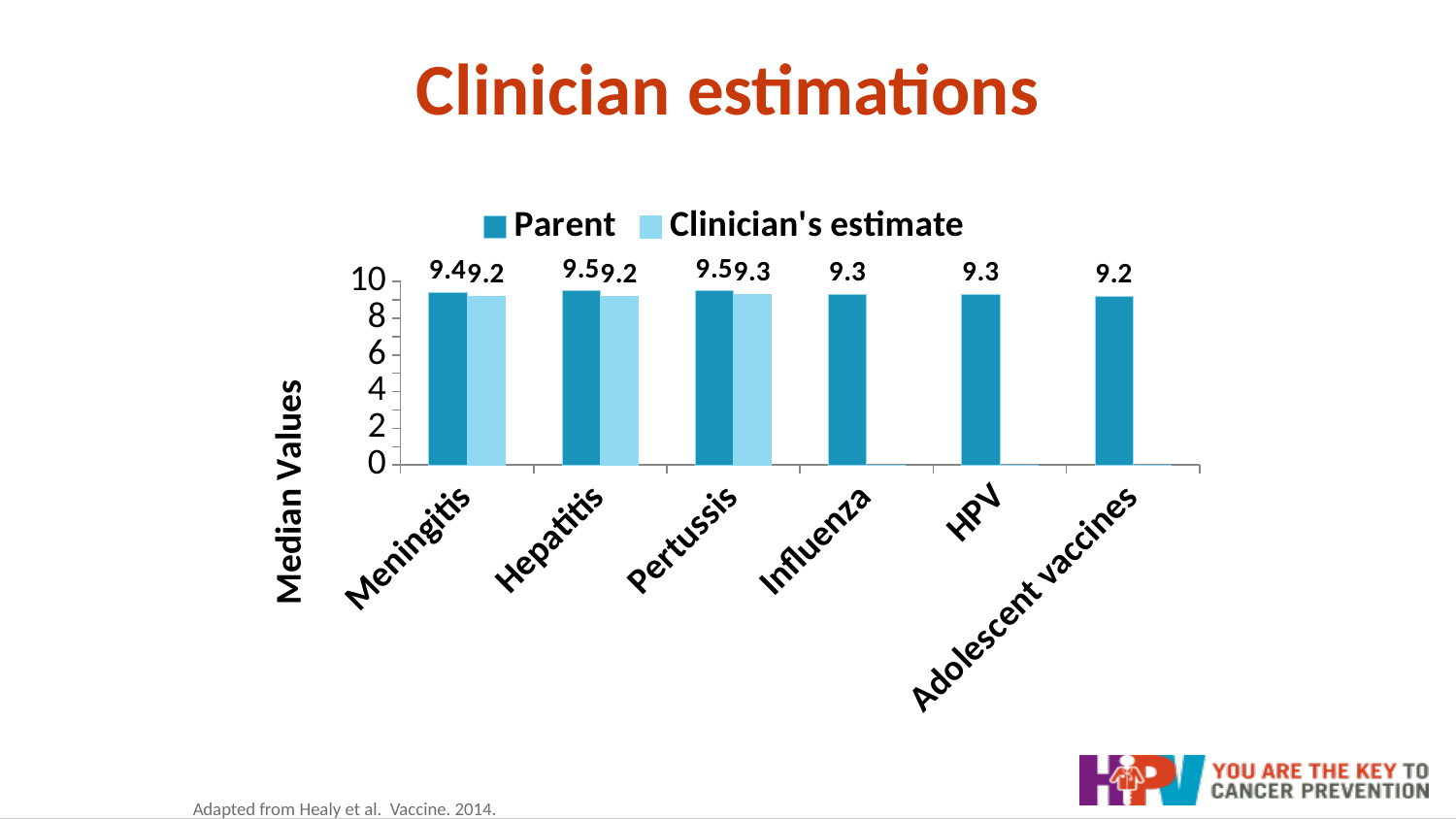
Is the Parent value for Influenza greater or less than 8? greater For Meningitis, which is larger: the Parent value or the Clinician's estimate value? Parent What kind of chart is shown on the slide? Bar chart What is the Clinician's estimate value for Pertussis? 9.3 Which category has the highest Clinician's estimate value? Pertussis Which category has the lowest Parent value? Adolescent vaccines What is the Parent value for Adolescent vaccines? 9.2 What is the Parent value for Meningitis? 9.4 How many series does the legend list? 2 What is the difference between the Parent and Clinician's estimate values for Hepatitis? 0.3 What is the Clinician's estimate value for Hepatitis? 9.2 How many categories are shown on the x axis? 6